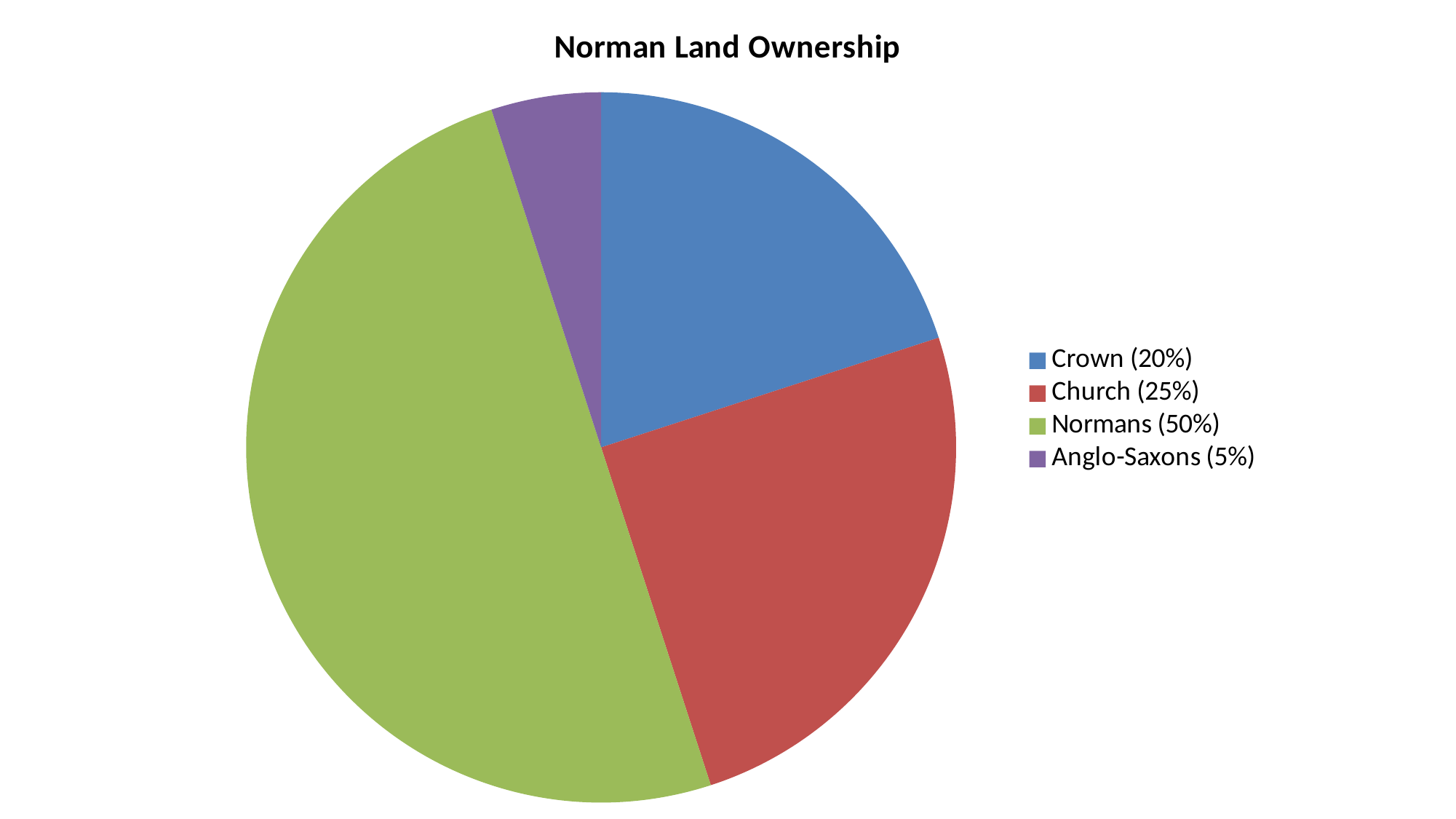
What share of land is owned by the Anglo-Saxons? 5% Which group owns the largest share of land? Normans What is the title of the chart? Norman Land Ownership Which owns a larger share of land, the Crown or the Church? Church What share of land is owned by the Crown? 20% What is the difference in percentage points between the Normans' share and the Church's share? 25 What share of land is owned by the Normans? 50% Which group owns the smallest share of land? Anglo-Saxons What kind of chart is shown on the slide? Pie chart What colour is the slice representing the Normans? Green How many categories does the pie chart show? 4